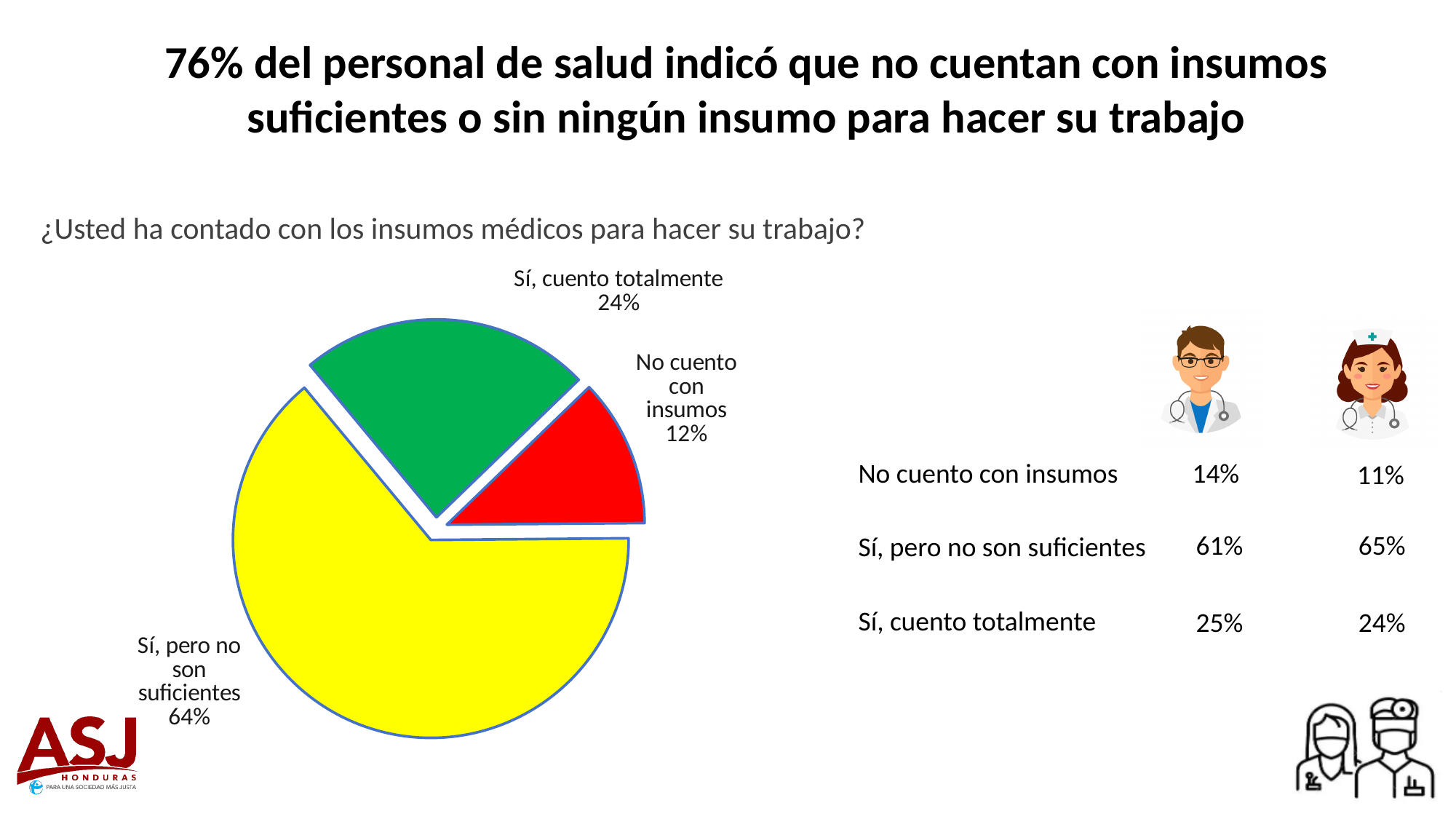
In the pie chart, what share of respondents answered "Sí, pero no son suficientes"? 64% In the pie chart, which is larger: "Sí, cuento totalmente" or "No cuento con insumos"? Sí, cuento totalmente What colour is the "Sí, pero no son suficientes" slice in the pie chart? yellow In the pie chart, what is the difference in percentage points between "Sí, cuento totalmente" and "No cuento con insumos"? 12 In the pie chart, what share of respondents answered "Sí, cuento totalmente"? 24% Which slice of the pie chart is the largest? Sí, pero no son suficientes What colour is the "No cuento con insumos" slice in the pie chart? red How many slices does the pie chart have? 3 Which slice of the pie chart is the smallest? No cuento con insumos In the pie chart, what share of respondents answered "No cuento con insumos"? 12% What kind of chart is shown on the slide? pie chart In the pie chart, what is the difference in percentage points between "Sí, pero no son suficientes" and "Sí, cuento totalmente"? 40